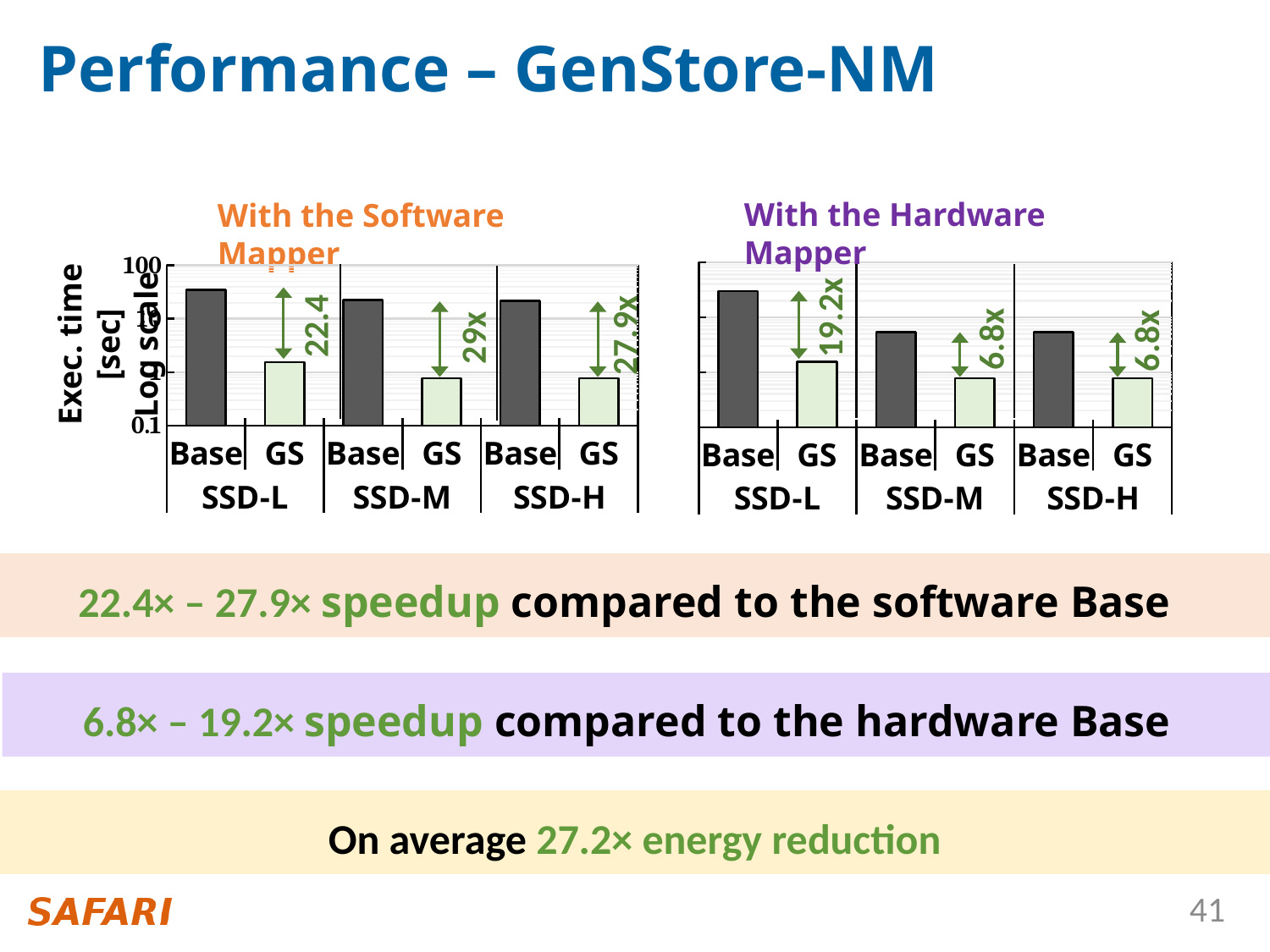
In the 'With the Software Mapper' chart, what speedup is annotated for SSD-M? 29x What kind of chart is the 'With the Software Mapper' chart? Bar chart In the 'With the Hardware Mapper' chart, which SSD configuration has the highest annotated speedup? SSD-L In the 'With the Hardware Mapper' chart, what speedup is annotated for SSD-L? 19.2x In the 'With the Software Mapper' chart, which SSD configuration has the highest annotated speedup? SSD-M In the 'With the Software Mapper' chart, what is the difference between the annotated speedups for SSD-M and SSD-H? 1.1x In the 'With the Software Mapper' chart, is the Base execution time for SSD-L greater or less than 10? greater In the 'With the Hardware Mapper' chart, which Base bar is taller, SSD-L or SSD-M? SSD-L In the 'With the Software Mapper' chart, what speedup is annotated for SSD-H? 27.9x How many SSD configurations are shown in the 'With the Hardware Mapper' chart? 3 In the 'With the Hardware Mapper' chart, what speedup is annotated for SSD-H? 6.8x In the 'With the Software Mapper' chart, what speedup is annotated for SSD-L? 22.4